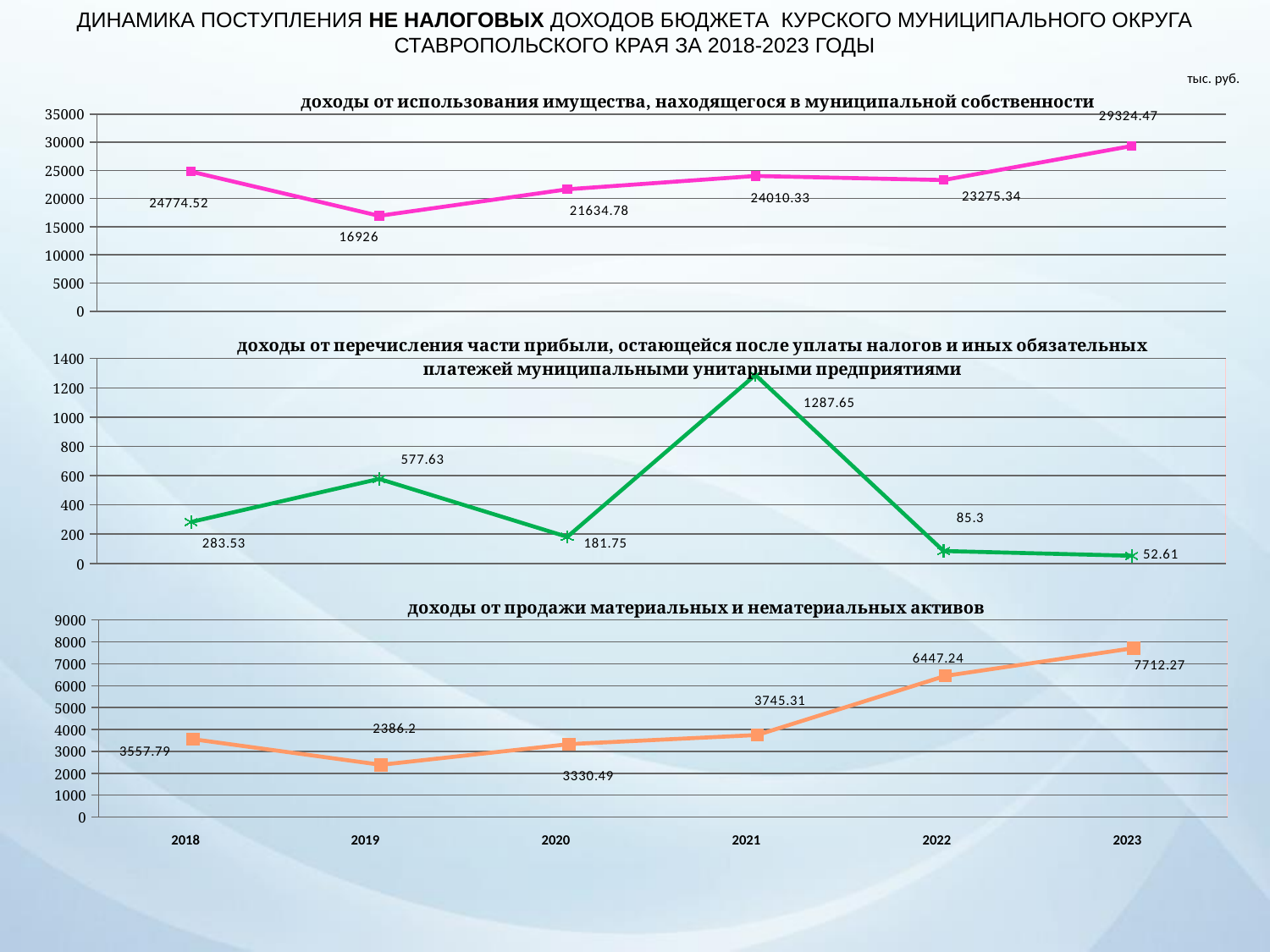
In the bottom chart (доходы от продажи материальных и нематериальных активов), what is the value for 2022? 6447.24 How many data points are plotted in the bottom chart (доходы от продажи материальных и нематериальных активов)? 6 In the bottom chart (доходы от продажи материальных и нематериальных активов), what is the difference between the 2023 value and the 2022 value? 1265.03 In the middle chart (доходы от перечисления части прибыли), is the value for 2019 larger or smaller than the value for 2020? larger In the top chart (доходы от использования имущества), what is the difference between the 2023 value and the 2018 value? 4549.95 In the middle chart (доходы от перечисления части прибыли), which year has the lowest value? 2023 What type of chart is the middle chart (доходы от перечисления части прибыли)? line chart What unit of measurement is indicated in the top right of the slide? тыс. руб. In the bottom chart (доходы от продажи материальных и нематериальных активов), do the values rise or fall from 2020 to 2023? rise In the top chart (доходы от использования имущества), which year has the highest value? 2023 In the top chart (доходы от использования имущества), what is the value for 2019? 16926 In the middle chart (доходы от перечисления части прибыли), what is the value for 2021? 1287.65